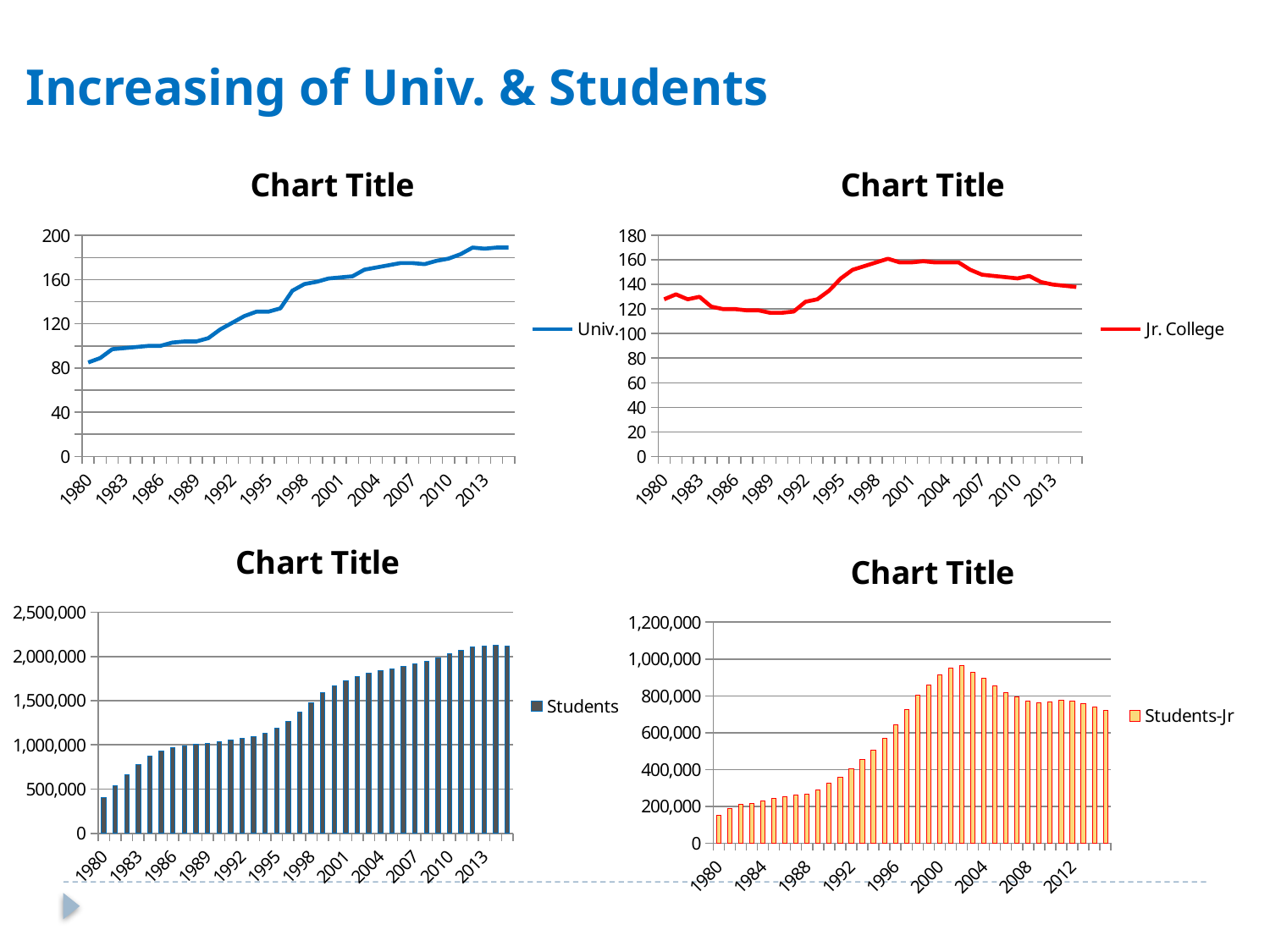
How many series does the legend of the bottom-right chart list? 1 What kind of chart is the top-left chart on the slide? line chart In the bottom-left chart, is the value for Students in 1980 greater or less than 500,000? less In the top-left chart, is the value for Univ. in 1980 greater or less than 100? less In the top-right chart, do the Jr. College values rise or fall from 2001 to 2013? fall In the top-right chart, is the value for Jr. College in 1989 greater or less than 140? less What kind of chart is the bottom-right chart on the slide? bar chart In the top-left chart, do the Univ. values generally rise or fall from 1980 to 2013? rise